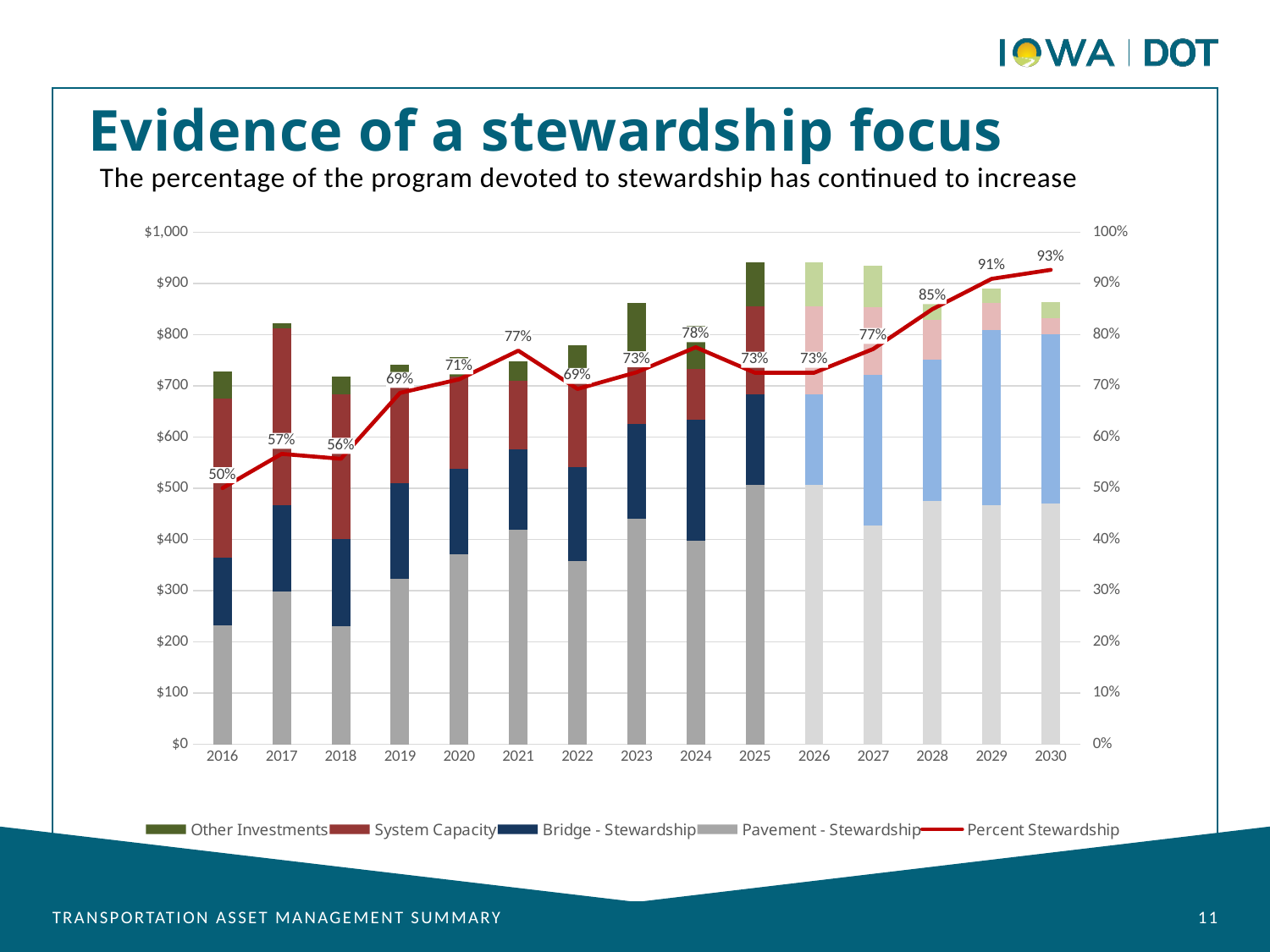
Is the total stacked bar value for 2016 greater or less than $800? less What is the Percent Stewardship value for 2028? 85% Is the total stacked bar value for 2025 greater or less than $900? greater Which year has the highest Percent Stewardship? 2030 What is the Percent Stewardship value for 2030? 93% By how many percentage points does Percent Stewardship in 2030 exceed that in 2016? 43 percentage points Which year has a higher Percent Stewardship, 2021 or 2022? 2021 What is the Percent Stewardship value for 2016? 50% How many years are shown on the x axis? 15 How many series does the legend list? 5 Which year has the lowest Percent Stewardship? 2016 What is the Percent Stewardship value for 2024? 78%